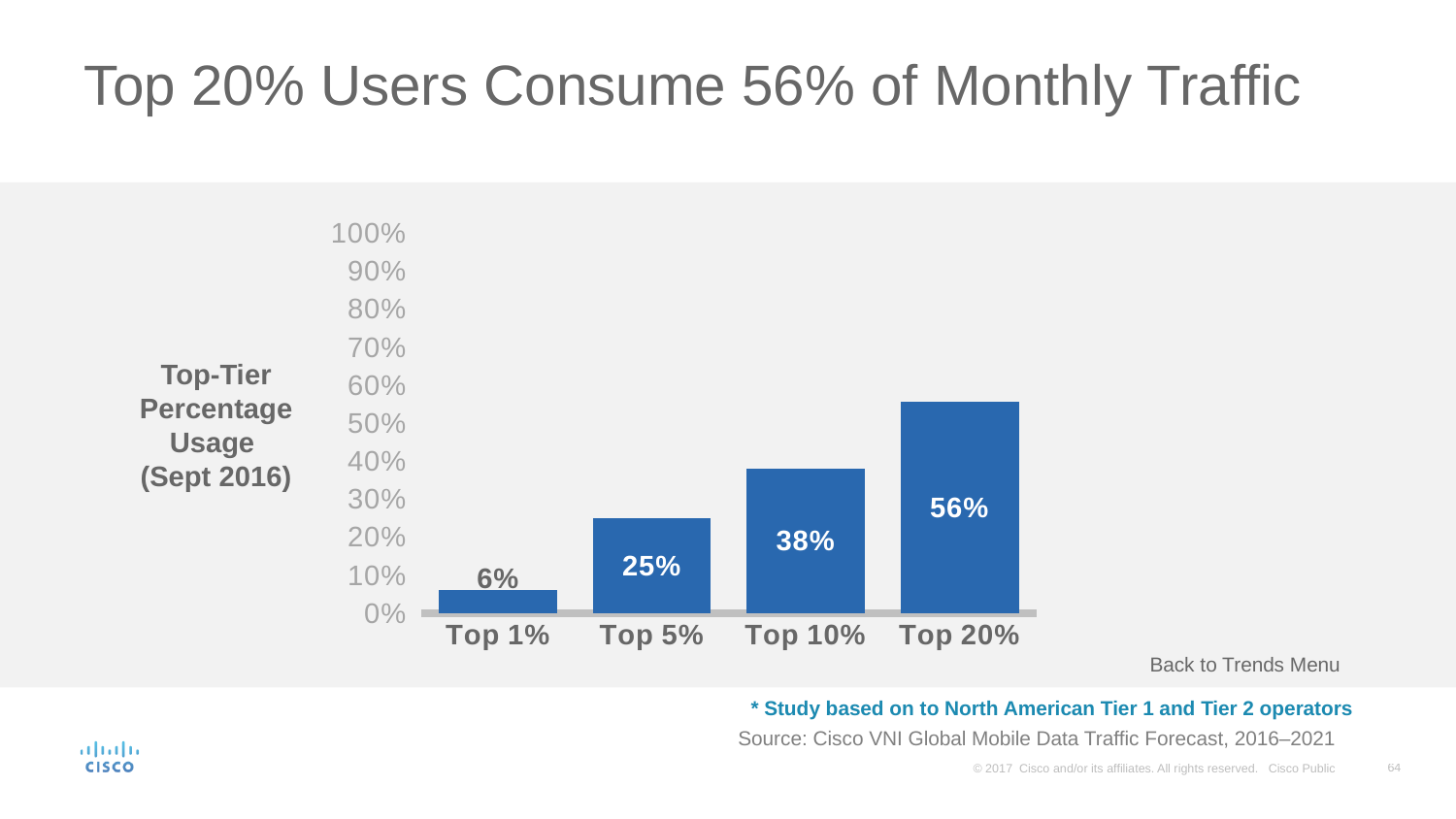
What is the value for Top 20%? 56% Which is larger, the value for Top 5% or the value for Top 10%? Top 10% What kind of chart is shown on the slide? bar chart What is the difference between the values for Top 20% and Top 10%? 18% Is the value for Top 20% greater or less than 50%? greater How many categories are shown on the x axis? 4 Which category has the highest value? Top 20% What is the value for Top 10%? 38% Do the values rise or fall from Top 1% to Top 20%? rise What is the value for Top 5%? 25% Which category has the lowest value? Top 1% What is the value for Top 1%? 6%